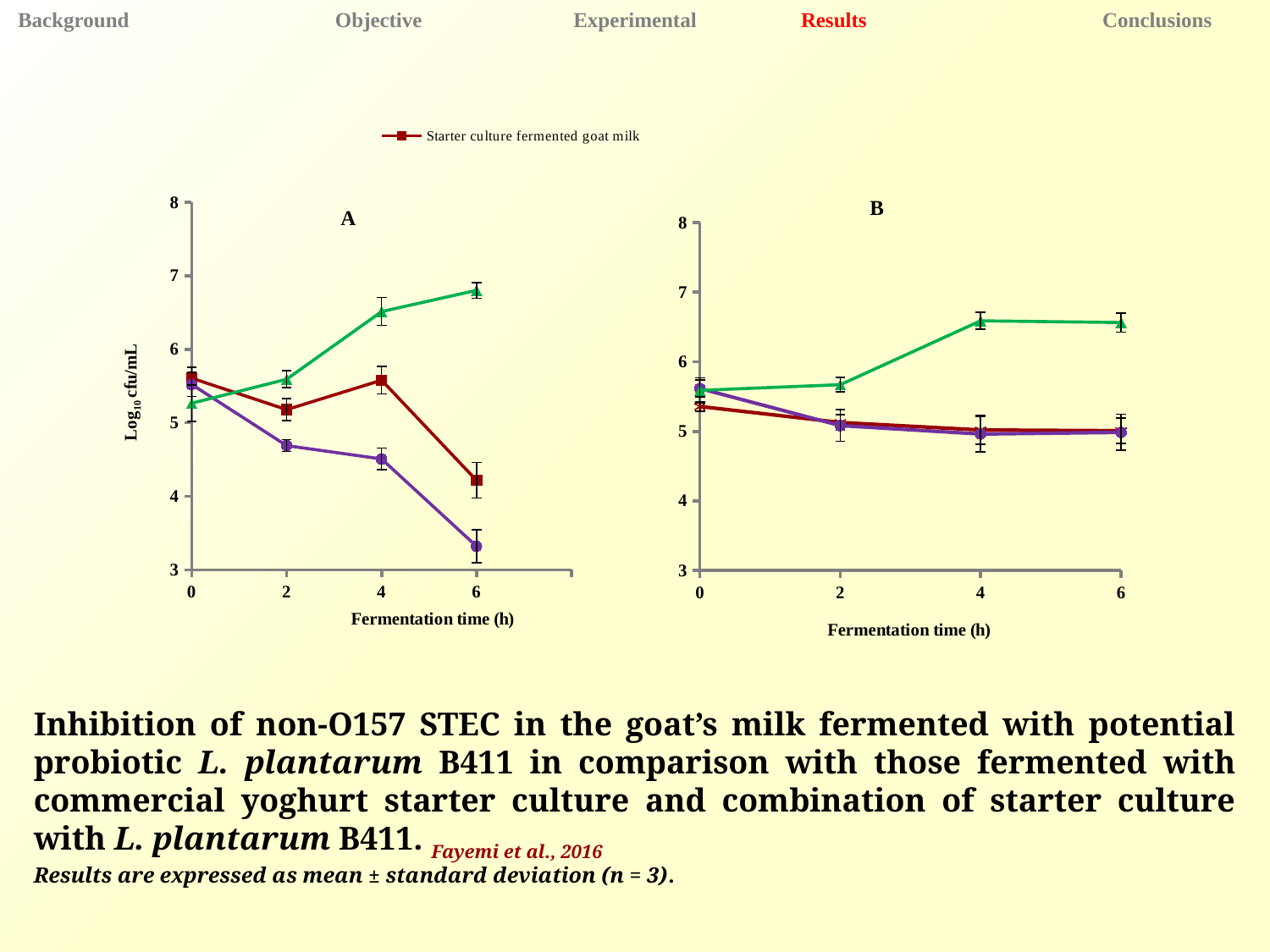
In chart A, does the purple circle series rise or fall from 0 h to 6 h? fall What kind of chart is chart A? line chart In chart A, how many fermentation time points are plotted along the x axis? 4 What is the label of the x axis in chart B? Fermentation time (h) In chart B, is the value of the green triangle series at 4 h greater or less than 6? greater In chart B, does the green triangle series rise or fall from 0 h to 6 h? rise In chart B, is the value of the Starter culture fermented goat milk series at 6 h greater or less than 6? less In chart A, is the value of the purple circle series at 6 h greater or less than 4? less What series name does the legend entry with the red square marker show? Starter culture fermented goat milk In chart A, which series has the highest value at 6 h? the green triangle series